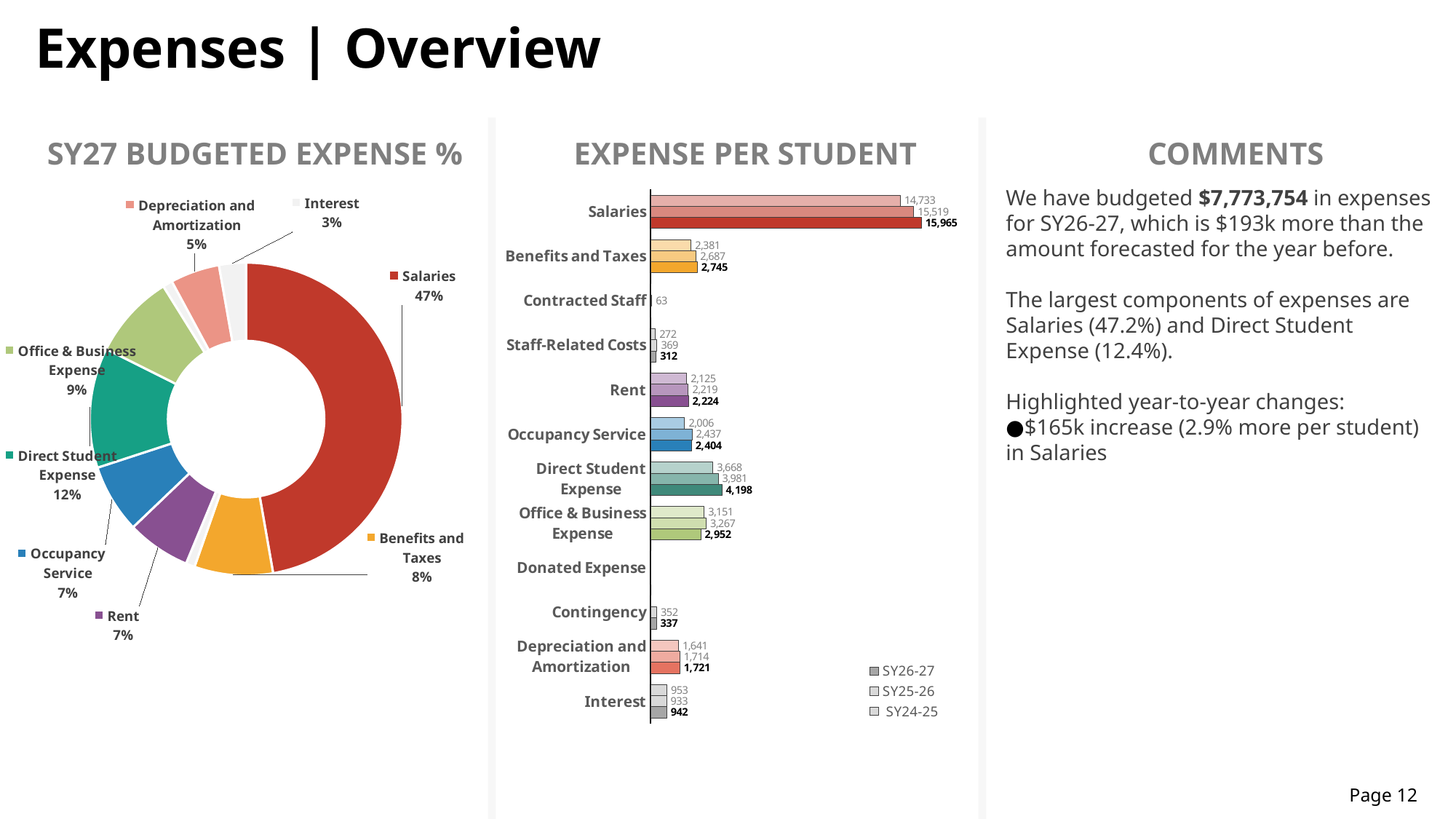
In the EXPENSE PER STUDENT chart, which is larger for SY26-27: Office & Business Expense or Direct Student Expense? Direct Student Expense In the SY27 BUDGETED EXPENSE % chart, which labeled category has the smallest slice? Interest In the SY27 BUDGETED EXPENSE % chart, what share of expenses is Salaries? 47% How many series does the legend of the EXPENSE PER STUDENT chart list? 3 In the EXPENSE PER STUDENT chart, what is the SY26-27 value for Direct Student Expense? 4,198 What kind of chart is the EXPENSE PER STUDENT chart? Bar chart In the EXPENSE PER STUDENT chart, what is the difference between the SY26-27 and SY25-26 values for Salaries? 446 In the SY27 BUDGETED EXPENSE % chart, what percentage is Direct Student Expense? 12% In the SY27 BUDGETED EXPENSE % chart, which category has the largest slice? Salaries In the EXPENSE PER STUDENT chart, what is the SY26-27 value for Salaries? 15,965 In the EXPENSE PER STUDENT chart, do the Salaries values rise or fall from SY24-25 to SY26-27? Rise How many labeled categories are shown in the SY27 BUDGETED EXPENSE % chart? 8